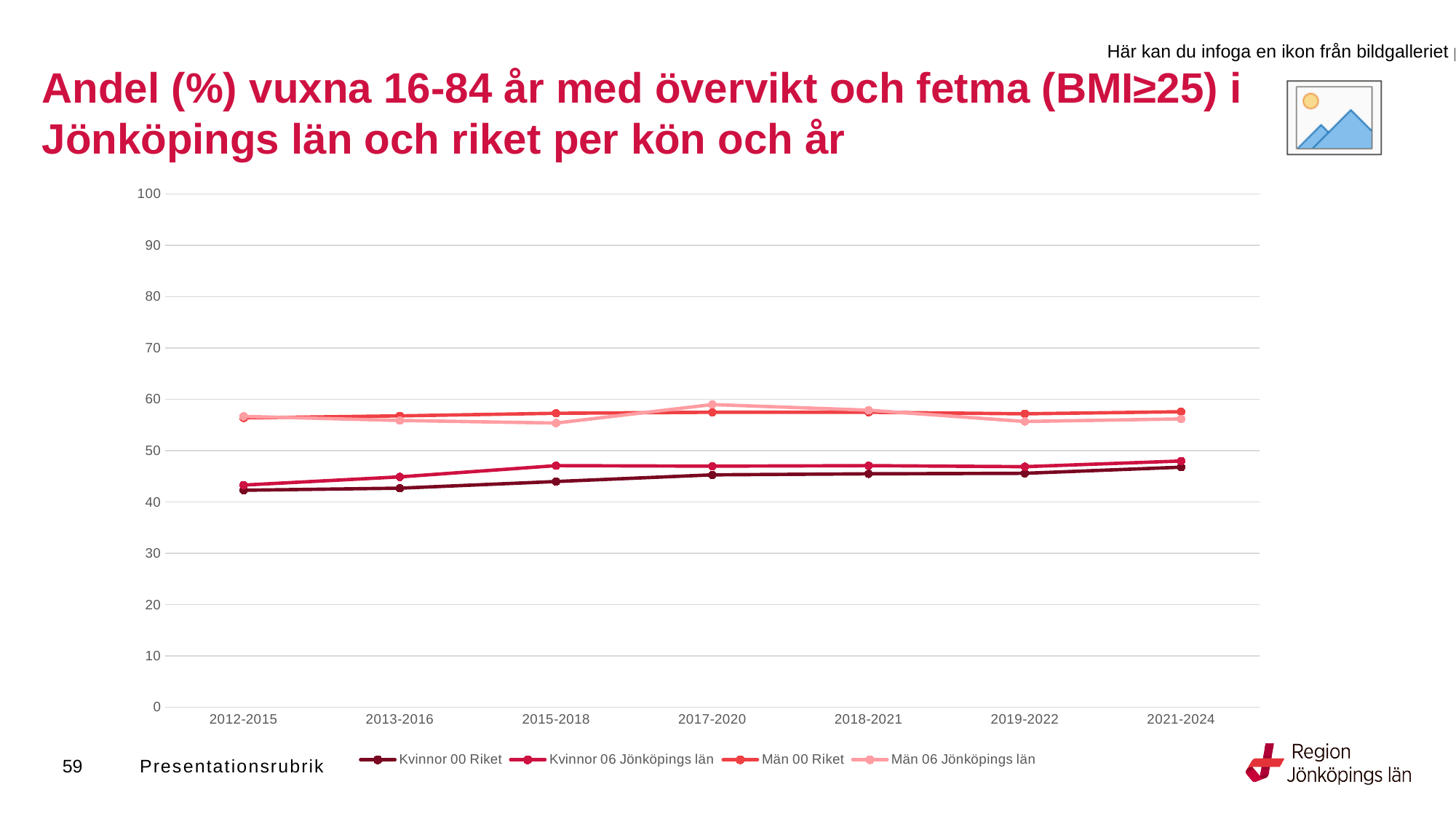
Which series is listed first in the legend? Kvinnor 00 Riket How many time periods are shown on the x axis? 7 Is the value for Kvinnor 00 Riket in 2012-2015 greater or less than 50? less Which series has the highest value in 2017-2020? Män 06 Jönköpings län Which series has the lowest value in 2015-2018? Kvinnor 00 Riket What kind of chart is shown on the slide? line chart Does the value for Kvinnor 00 Riket rise or fall from 2012-2015 to 2021-2024? rise Is the value for Kvinnor 06 Jönköpings län in 2021-2024 greater or less than 50? less Is the value for Män 06 Jönköpings län in 2017-2020 greater or less than 60? less How many series does the legend list? 4 In 2015-2018, which is larger: Kvinnor 06 Jönköpings län or Kvinnor 00 Riket? Kvinnor 06 Jönköpings län